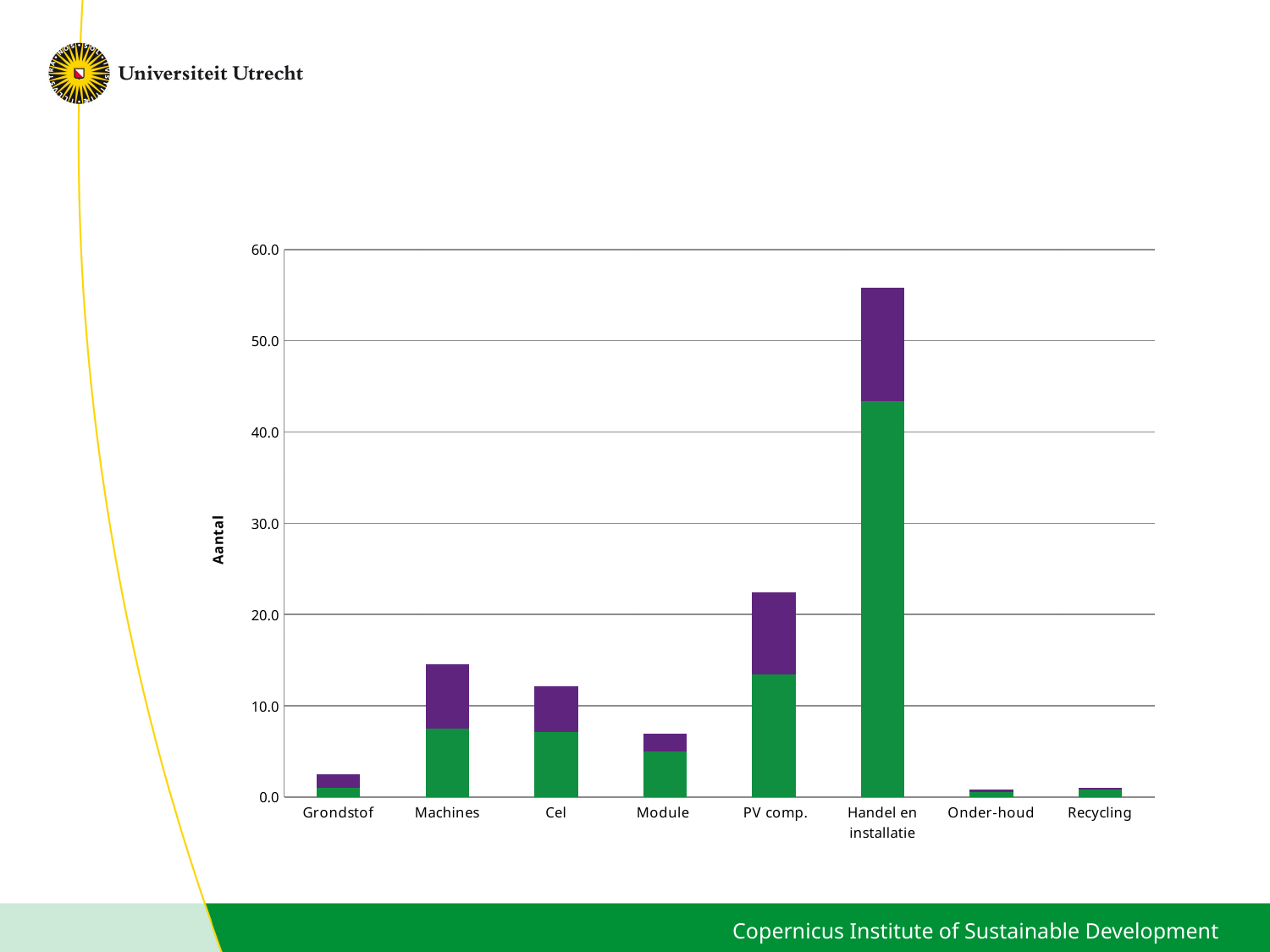
Is the total value of the bar for Machines greater or less than 10? greater How many categories are shown on the x axis of the chart? 8 What is the label on the y axis of the chart? Aantal Is the total value of the bar for Handel en installatie greater or less than 50? greater What kind of chart is shown on the slide? Stacked bar chart Is the total value of the bar for Grondstof greater or less than 10? less Which bar is taller, PV comp. or Module? PV comp. Which category has the tallest bar in the chart? Handel en installatie What two colours are used for the stacked segments in the bars? Green and purple Which bar is taller, Machines or Cel? Machines